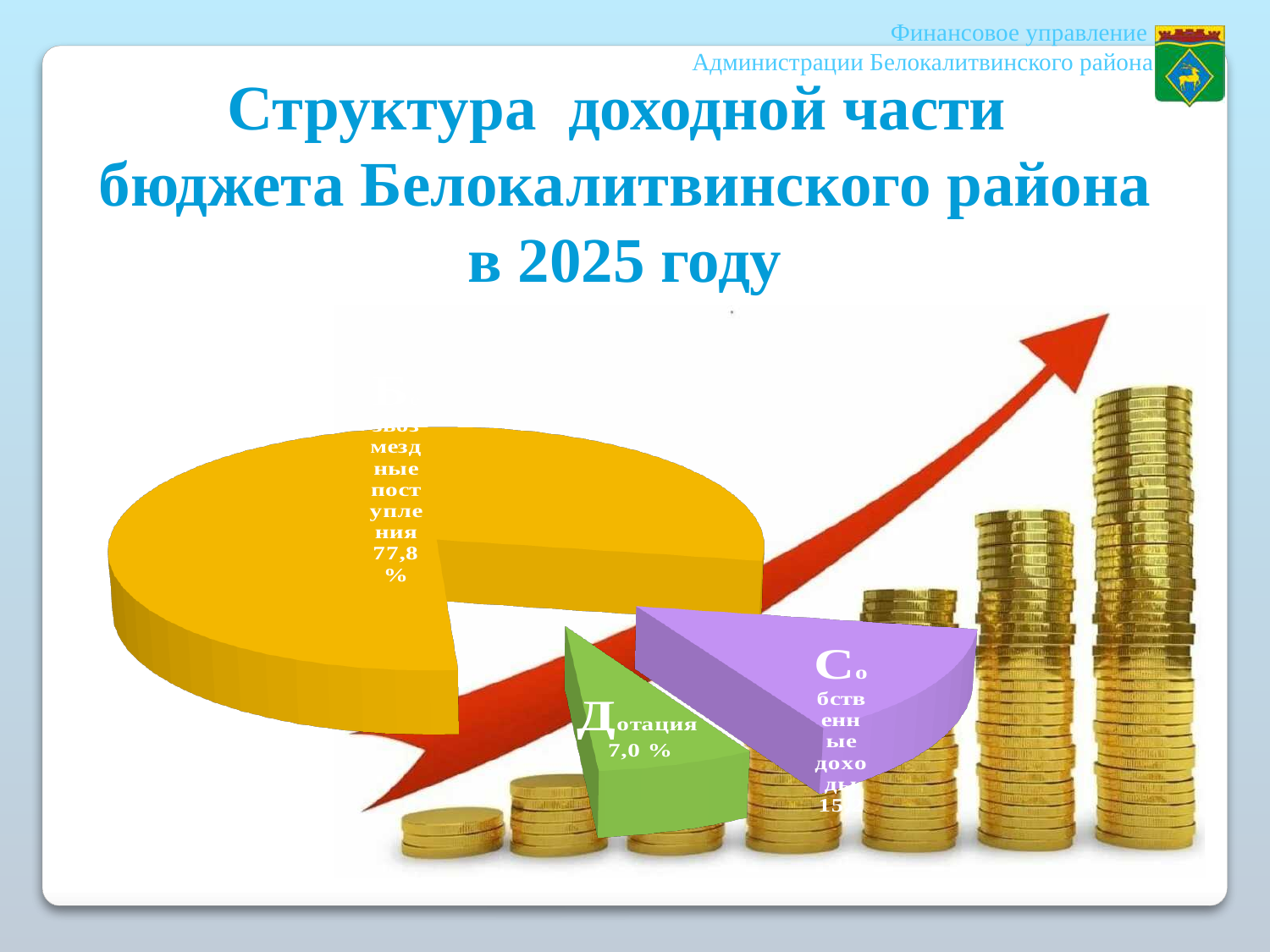
Which is larger: the share for Безвозмездные поступления or the share for Дотация? Безвозмездные поступления Which slice of the pie chart is the smallest? Дотация What colour is the Дотация slice of the pie chart? green By how many percentage points does the share for Безвозмездные поступления exceed the share for Дотация? 70,8 % What share of the pie is labelled for Дотация? 7,0 % What colour is the Собственные доходы slice of the pie chart? purple Which is larger: the share for Собственные доходы or the share for Дотация? Собственные доходы Which slice of the pie chart is the largest? Безвозмездные поступления What share of the pie is labelled for Безвозмездные поступления? 77,8 % How many slices does the pie chart have? 3 What kind of chart is shown on the slide? pie chart